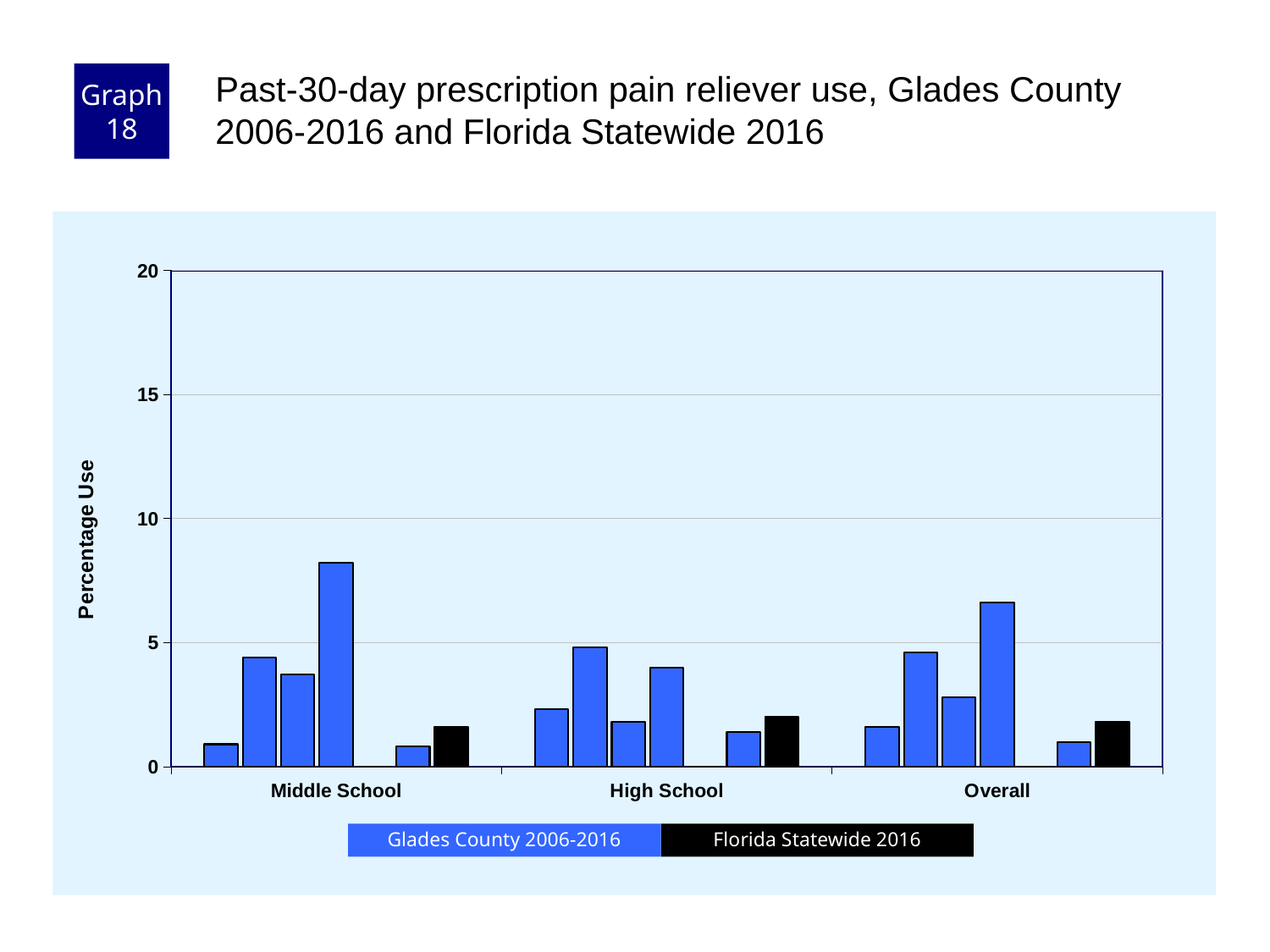
What kind of chart is shown on the slide? bar chart Is the tallest Glades County 2006-2016 bar in the Middle School group greater or less than 5? greater How many series does the legend list? 2 Is the Florida Statewide 2016 value larger for High School or for Middle School? High School In which group does the tallest bar on the chart appear? Middle School Is the tallest Glades County 2006-2016 bar in the Overall group greater or less than 5? greater How many school-level groups are shown on the x axis? 3 Is the tallest Glades County 2006-2016 bar in the High School group greater or less than 10? less What is the title of the y axis? Percentage Use Which series is shown in black in the legend? Florida Statewide 2016